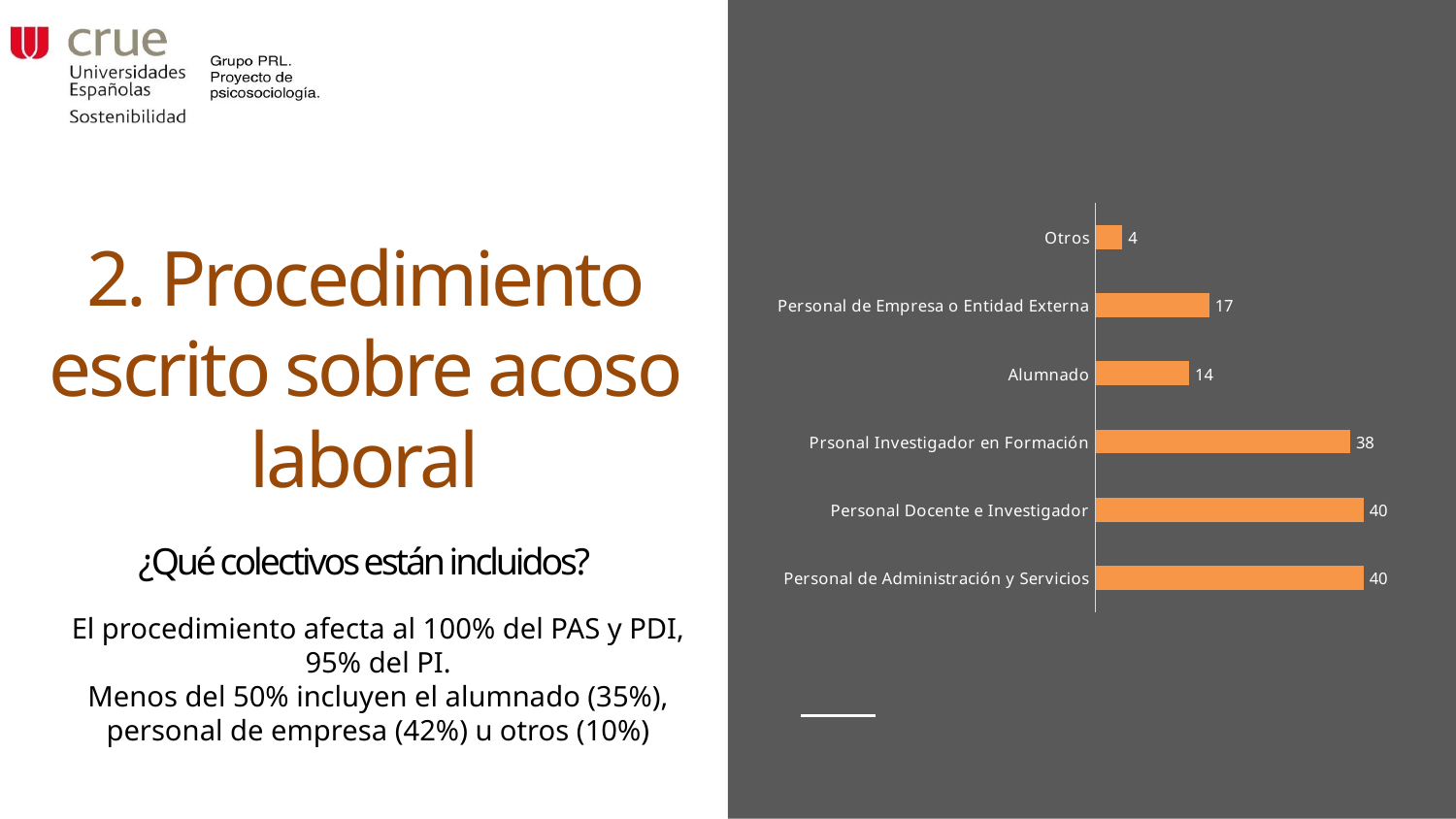
What value is shown for Personal Docente e Investigador? 40 What value is shown for Personal de Empresa o Entidad Externa? 17 What colour are the bars in the chart? Orange What value is shown for Prsonal Investigador en Formación? 38 How many categories are shown in the chart? 6 What kind of chart is shown on the slide? Bar chart What is the difference between the values for Personal de Administración y Servicios and Prsonal Investigador en Formación? 2 Which category has the lowest value? Otros What value is shown for Otros? 4 What is the difference between the values for Personal de Empresa o Entidad Externa and Alumnado? 3 Which is larger, the value for Alumnado or the value for Personal de Empresa o Entidad Externa? Personal de Empresa o Entidad Externa What value is shown for Alumnado? 14